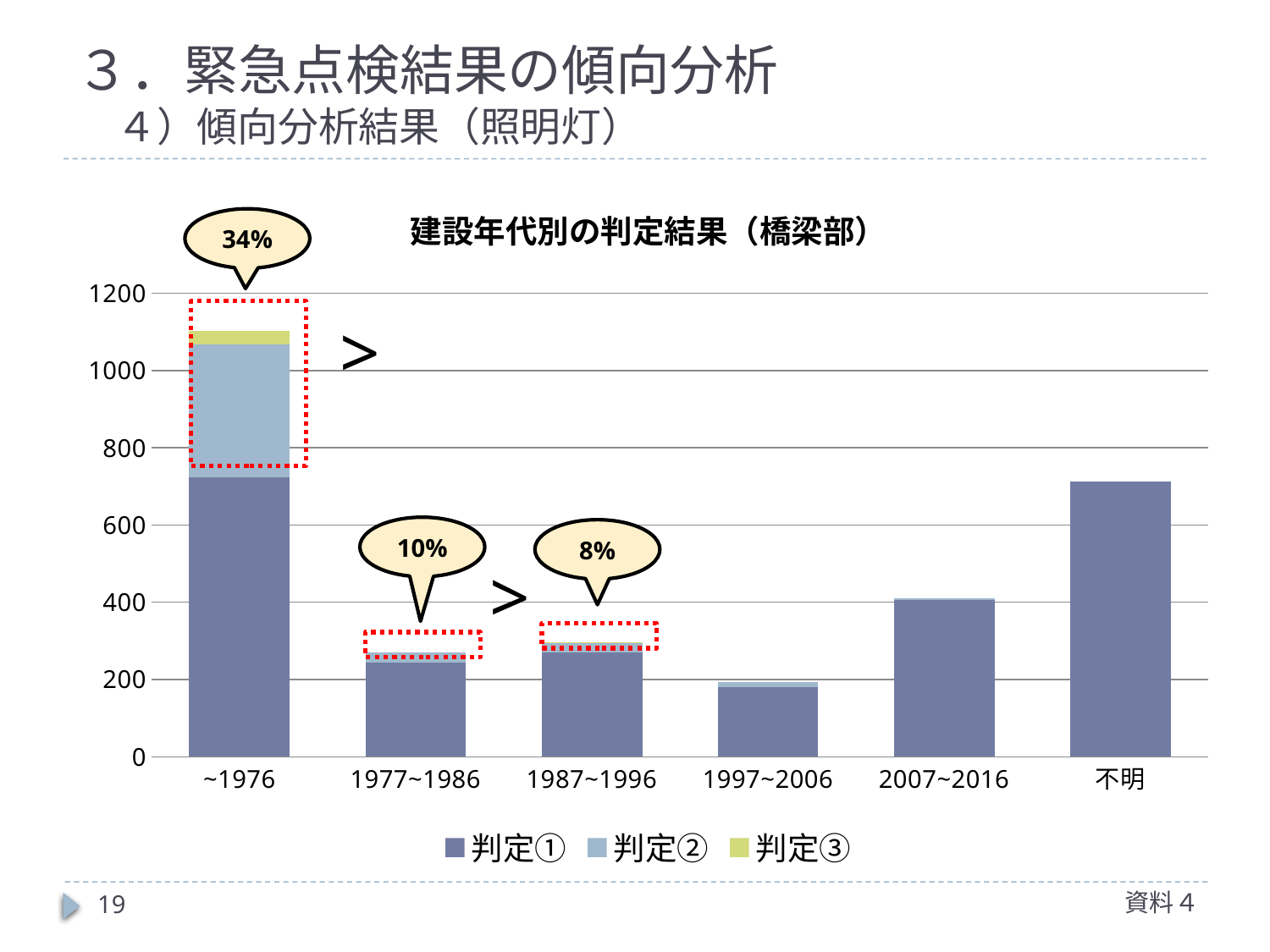
Is the total height of the 不明 bar greater or less than 600? greater Is the total height of the ~1976 bar greater or less than 1000? greater What kind of chart is shown on the slide? stacked bar chart How many series does the legend list? 3 Is the total height of the 2007~2016 bar greater or less than 600? less How many construction-period categories are shown on the x axis? 6 What is the title of the chart? 建設年代別の判定結果（橋梁部） What percentage is shown in the callout above the ~1976 bar? 34% Which category has the tallest stacked bar? ~1976 Which category has the shortest stacked bar? 1997~2006 Which bar is taller, 不明 or 2007~2016? 不明